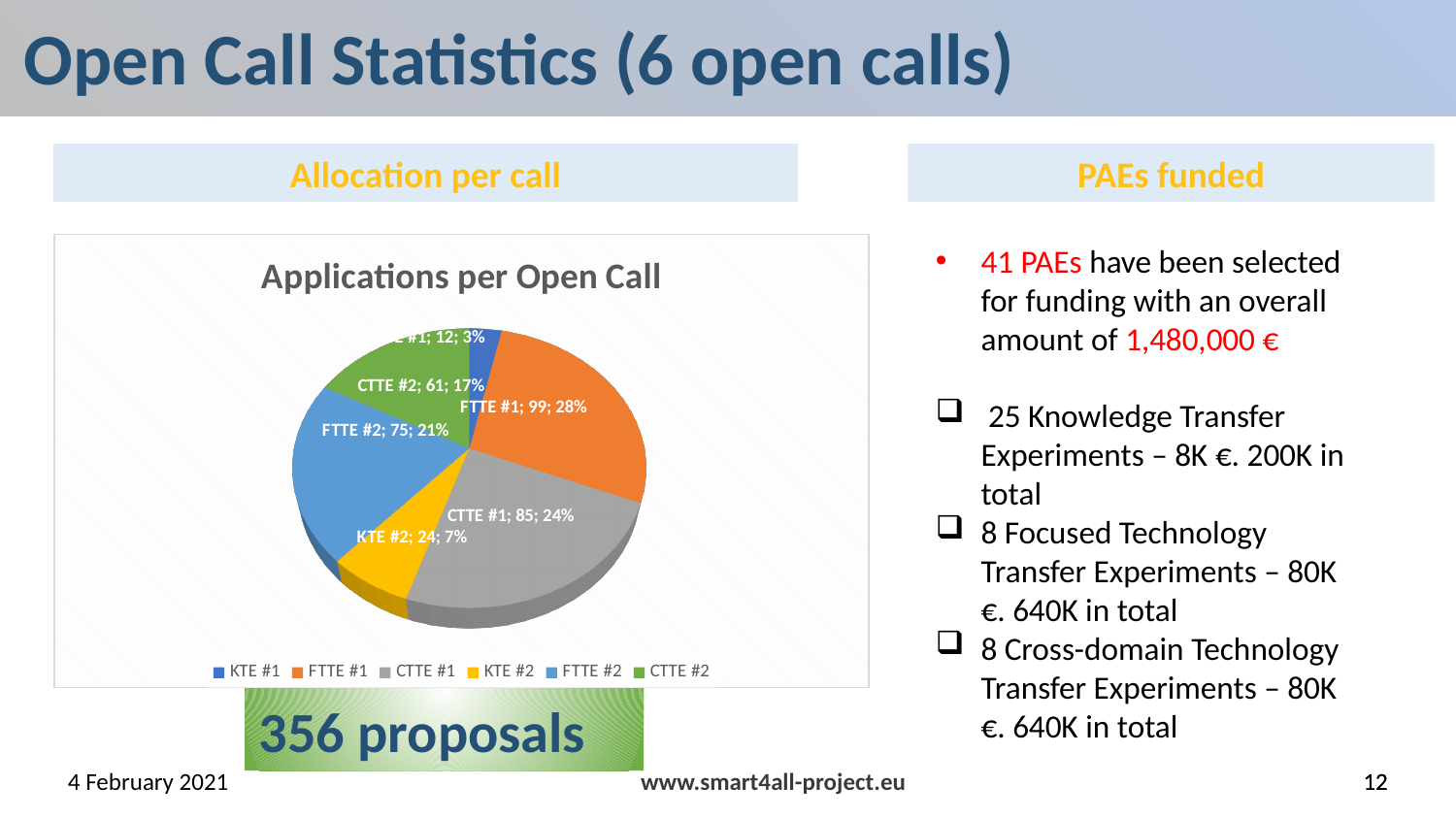
How many applications were received for FTTE #1? 99 How many categories does the legend of the pie chart list? 6 What is the difference in applications between FTTE #1 and CTTE #1? 14 What share of the pie does KTE #2 represent? 7% Which open call received the most applications? FTTE #1 Which open call received the fewest applications? KTE #1 Which received more applications, FTTE #2 or CTTE #2? FTTE #2 How many applications were received for FTTE #2? 75 How many applications were received for CTTE #1? 85 What share of the pie does CTTE #2 represent? 17% What is the title of the chart? Applications per Open Call What type of chart is shown on the slide? pie chart